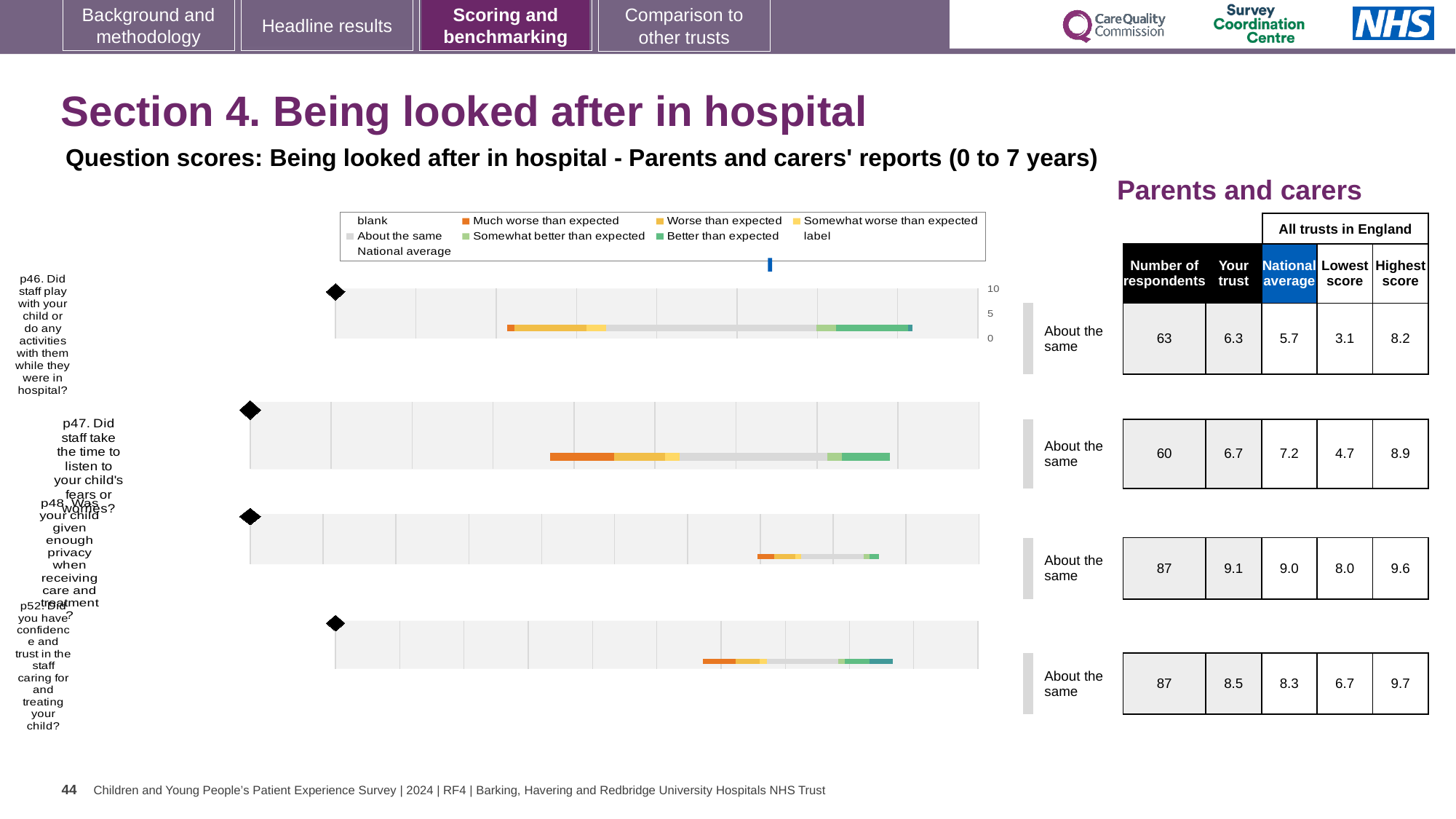
In the table next to the chart, what is the lowest score across all trusts in England for p47? 4.7 What benchmark category is shown beside each of the four bars in the chart? About the same In the table next to the chart, what is the highest score across all trusts in England for p52 (Did you have confidence and trust in the staff caring for and treating your child)? 9.7 In the table next to the chart, what is the national average for p48 (Was your child given enough privacy when receiving care and treatment)? 9.0 According to the table next to the chart, which question has the highest 'Your trust' score? p48 According to the table next to the chart, which question has the lowest 'Your trust' score? p46 According to the table next to the chart, what is the difference between the national average and the 'Your trust' score for p47? 0.5 What kind of chart is used to show the question scores on this slide? bar chart How many survey questions are plotted in the chart? 4 In the table next to the chart, what is the 'Your trust' score for p47 (Did staff take the time to listen to your child's fears or worries)? 6.7 In the table next to the chart, what is the number of respondents for p46 (Did staff play with your child or do any activities with them while they were in hospital)? 63 According to the table next to the chart, for p46 is the 'Your trust' score or the national average larger? Your trust